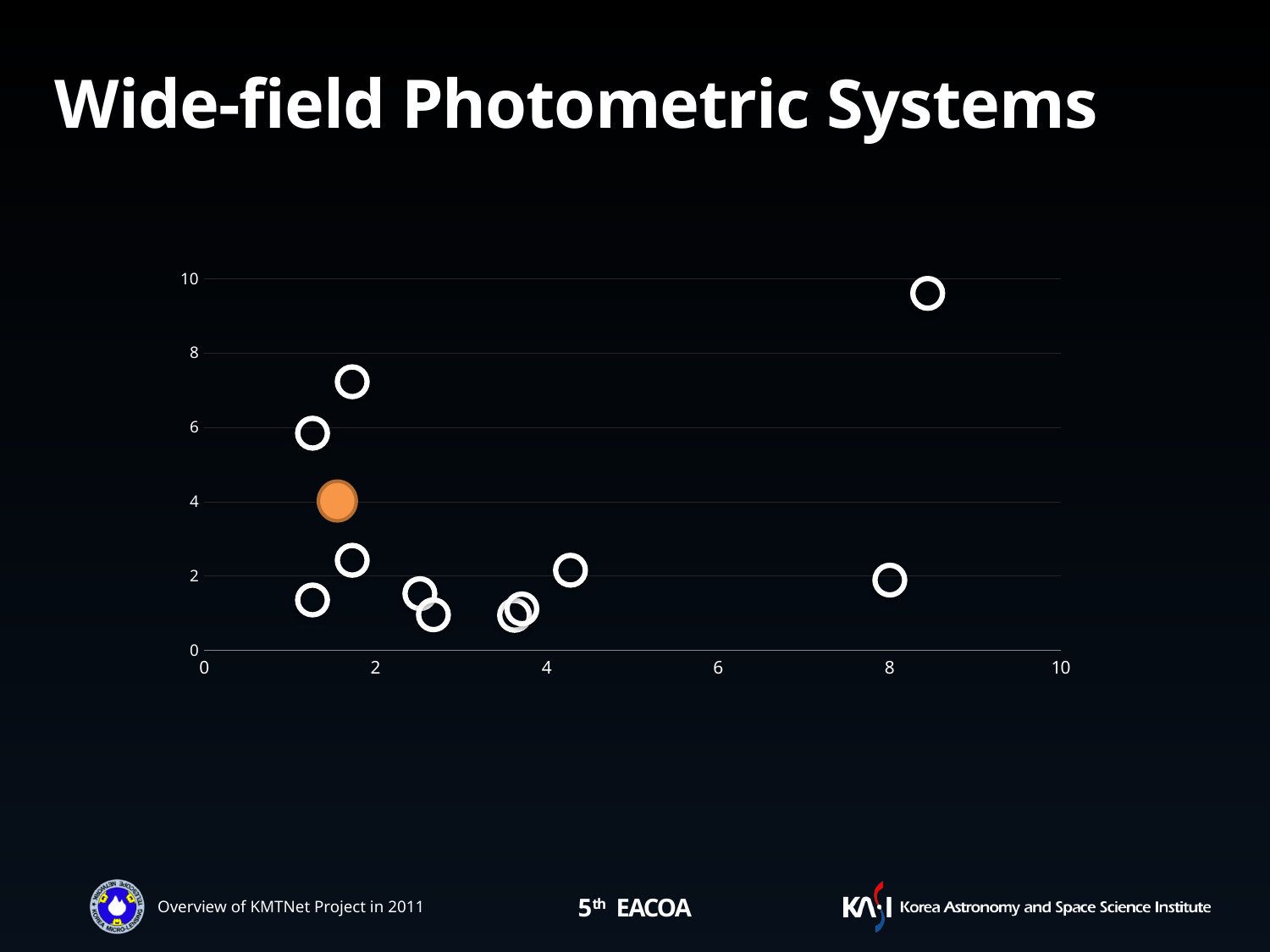
What is the maximum value shown on the y axis? 10 What kind of chart is shown on the slide? scatter chart Is the x value of the highest point on the chart greater or less than 8? greater What is the title of the slide containing the chart? Wide-field Photometric Systems Is the y value of the highest point on the chart greater or less than 8? greater Is the y value of the orange point greater or less than 2? greater Which has the larger y value: the orange point or the point near x = 8? the orange point How many orange points are plotted on the chart? 1 What colour is the single filled (highlighted) point on the chart? orange